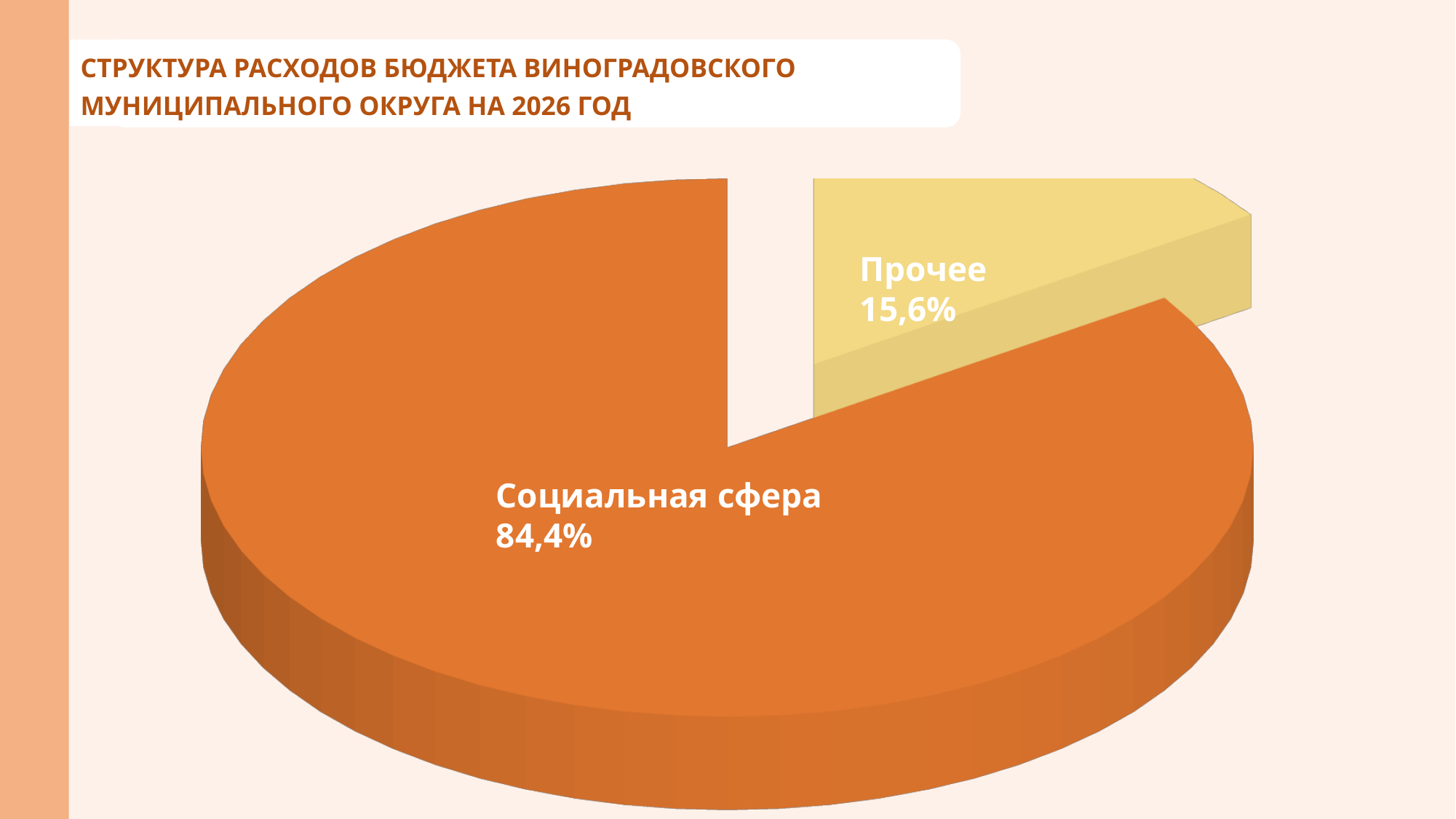
What share of the pie does Прочее have? 15,6% What is the title of the chart? СТРУКТУРА РАСХОДОВ БЮДЖЕТА ВИНОГРАДОВСКОГО МУНИЦИПАЛЬНОГО ОКРУГА НА 2026 ГОД Which slice of the pie is the largest? Социальная сфера Which is larger, Социальная сфера or Прочее? Социальная сфера Which slice of the pie is the smallest? Прочее What is the total of the two slices shown? 100% What share of the pie does Социальная сфера have? 84,4% How many slices does the pie chart have? 2 What is the difference in percentage points between Социальная сфера and Прочее? 68,8 What kind of chart is shown on the slide? Pie chart What colour is the Прочее slice? Yellow